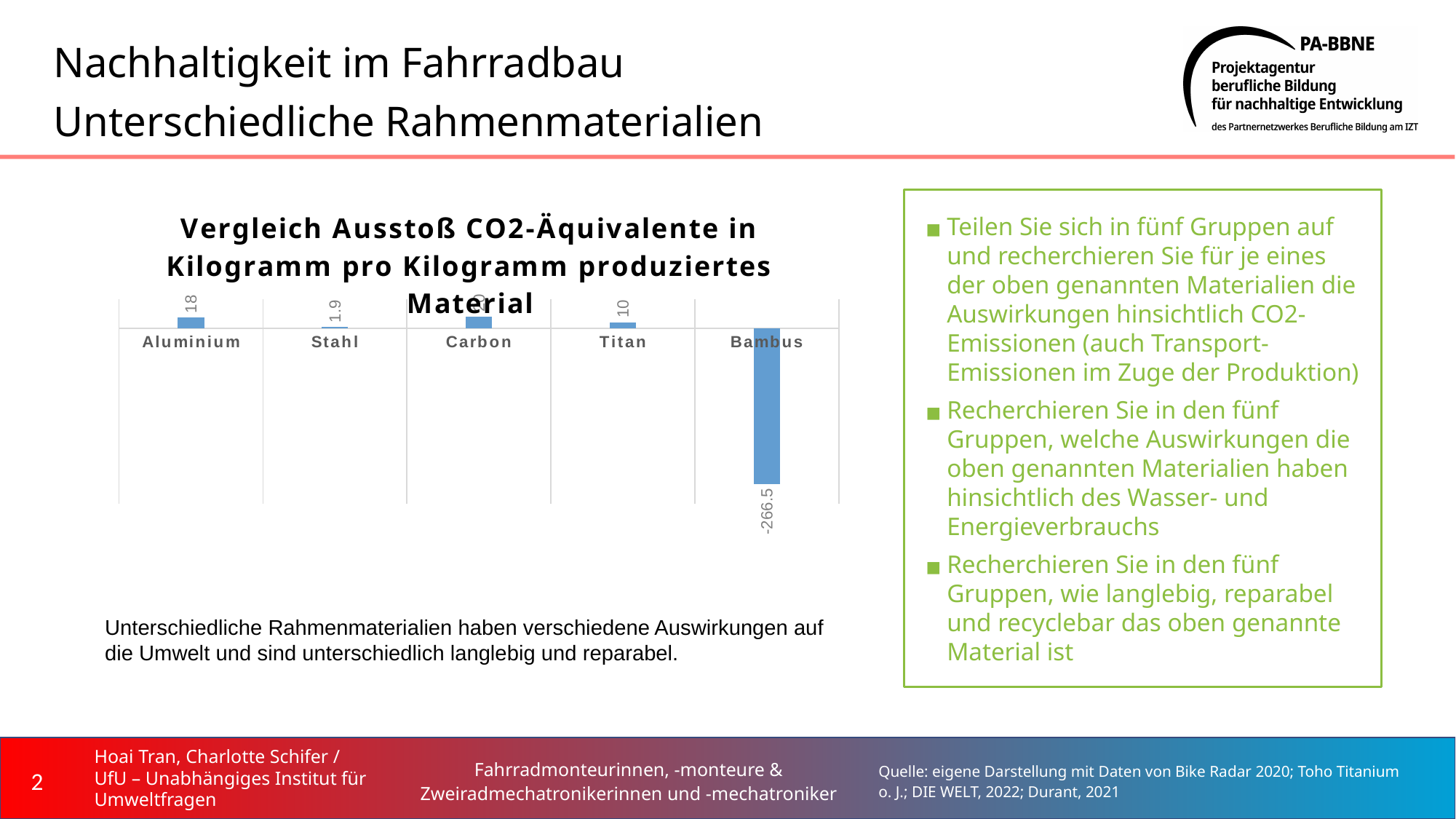
Which has the larger value, Stahl or Titan? Titan What kind of chart is shown on the slide? Bar chart What is the value for Aluminium in the chart? 18 What is the value for Stahl in the chart? 1.9 What is the value for Titan in the chart? 10 What is the title of the chart? Vergleich Ausstoß CO2-Äquivalente in Kilogramm pro Kilogramm produziertes Material Which has the larger value, Aluminium or Titan? Aluminium How many materials are shown in the chart? 5 What is the difference between the values for Titan and Stahl? 8.1 What is the value for Bambus in the chart? -266.5 What is the difference between the values for Aluminium and Titan? 8 Which material has the lowest value in the chart? Bambus